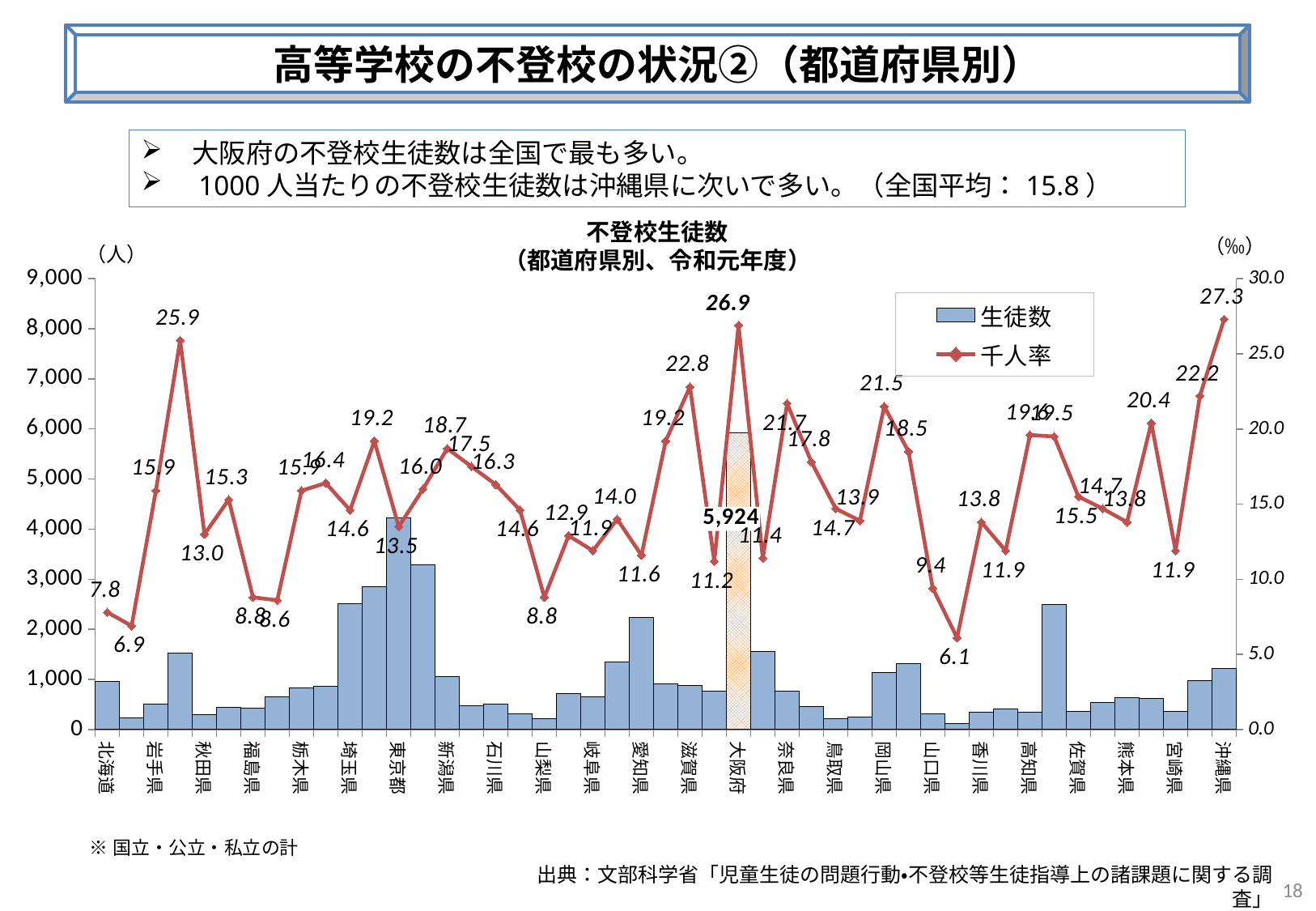
What is the 生徒数 value shown for 大阪府? 5,924 Is the 生徒数 value for 東京都 greater or less than 3,000? greater What is the 千人率 value for 北海道? 7.8 Which prefecture has the highest 千人率? 沖縄県 Which prefecture has the tallest 生徒数 bar? 大阪府 What is the 千人率 value for 大阪府? 26.9 Which has the larger 生徒数 bar, 大阪府 or 東京都? 大阪府 How many series does the legend list? 2 What is the 千人率 value for 沖縄県? 27.3 What is the difference between the 千人率 of 沖縄県 and 大阪府? 0.4 Is the 生徒数 value for 佐賀県 greater or less than 2,000? less What kind of chart is this? Combined bar and line chart